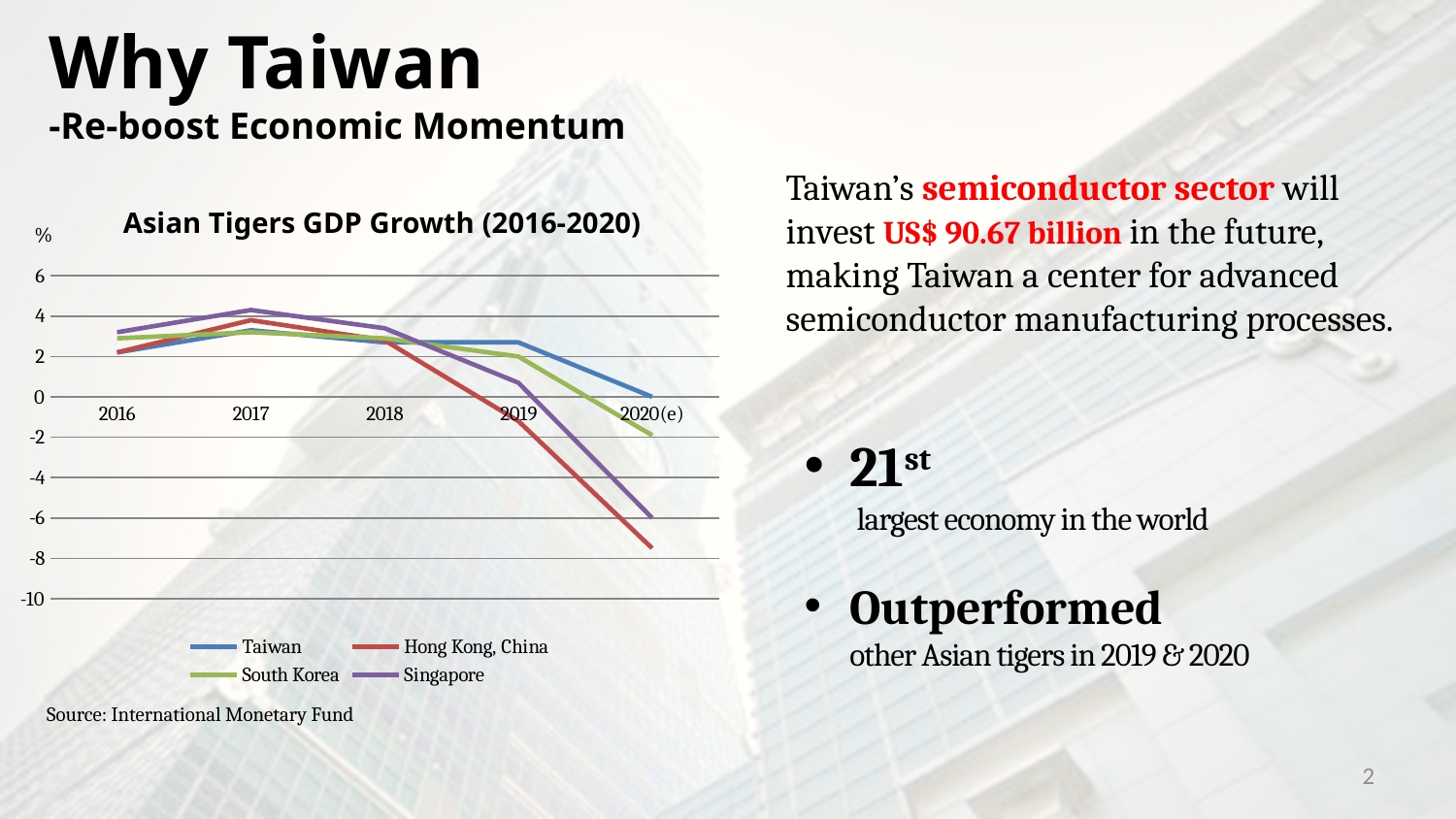
Is the value for Hong Kong, China in 2020(e) greater or less than -6? less What is the title of the chart on the slide? Asian Tigers GDP Growth (2016-2020) How many years are shown on the x axis of the Asian Tigers GDP Growth chart? 5 Which economy has the highest GDP growth in 2017? Singapore Which economy has the highest GDP growth in 2020(e)? Taiwan Which economy has the lowest GDP growth in 2020(e)? Hong Kong, China Is the value for South Korea in 2019 greater or less than 0? greater What kind of chart is shown on the slide? Line chart Does the GDP growth of Hong Kong, China rise or fall from 2017 to 2020(e)? Fall In 2019, which is larger: the GDP growth of Taiwan or of Hong Kong, China? Taiwan How many series does the legend of the Asian Tigers GDP Growth chart list? 4 Is the value for Singapore in 2017 greater or less than 4? greater